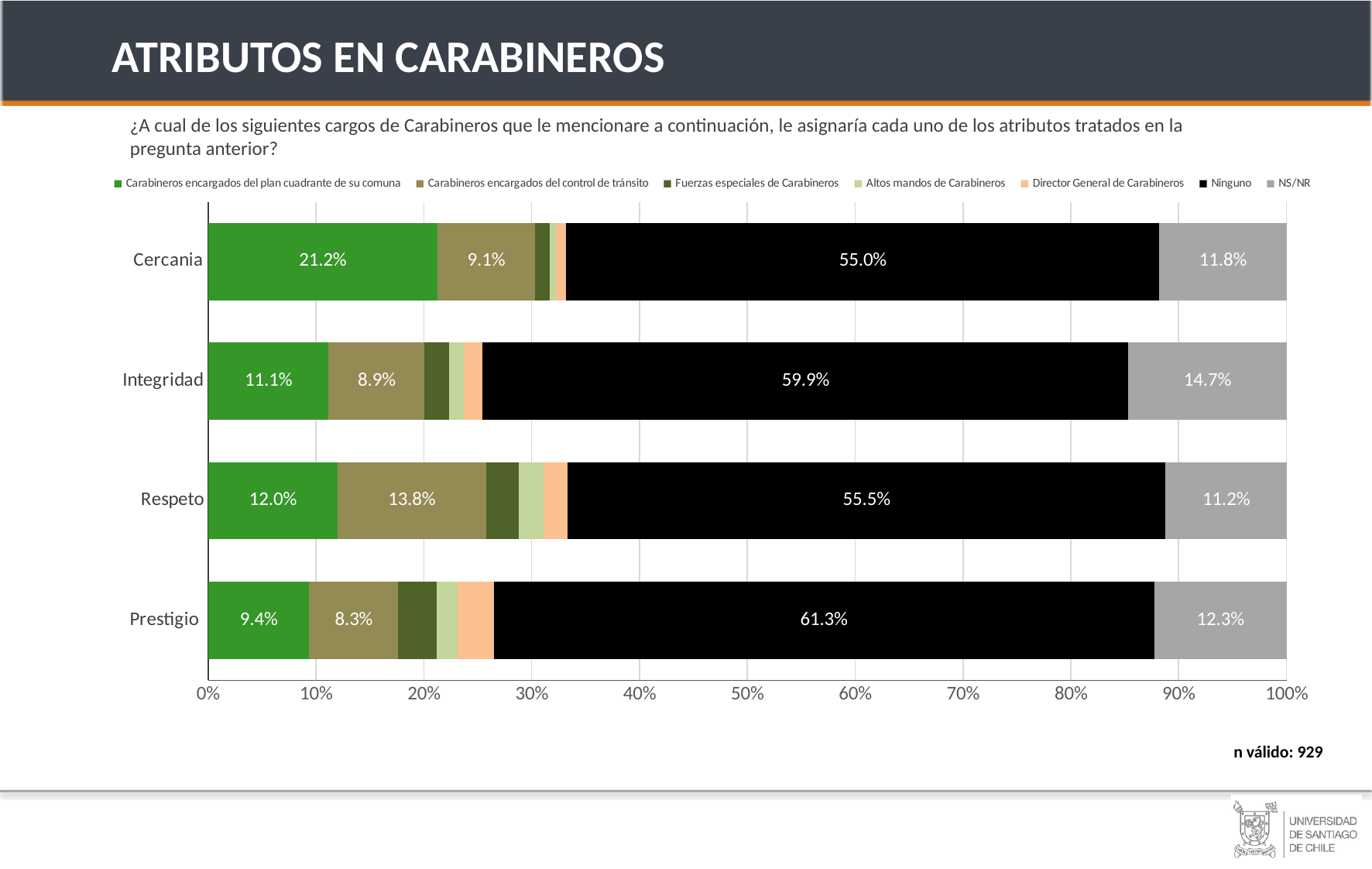
Which attribute has the highest value for 'Ninguno'? Prestigio Which is larger: the 'NS/NR' value for Integridad or for Respeto? Integridad What is the valid sample size (n válido) shown on the slide? 929 What kind of chart is shown on the slide? Stacked bar chart What is the value for 'Ninguno' in the Cercania bar? 55.0% What is the value for 'NS/NR' in the Prestigio bar? 12.3% How many series does the legend list? 7 Which attribute has the lowest value for 'Carabineros encargados del plan cuadrante de su comuna'? Prestigio What is the value for 'Carabineros encargados del control de tránsito' in the Respeto bar? 13.8% What is the value for 'Carabineros encargados del plan cuadrante de su comuna' in the Integridad bar? 11.1% What is the difference between the 'Ninguno' values for Prestigio and Cercania? 6.3% How many attribute categories are plotted on the chart? 4